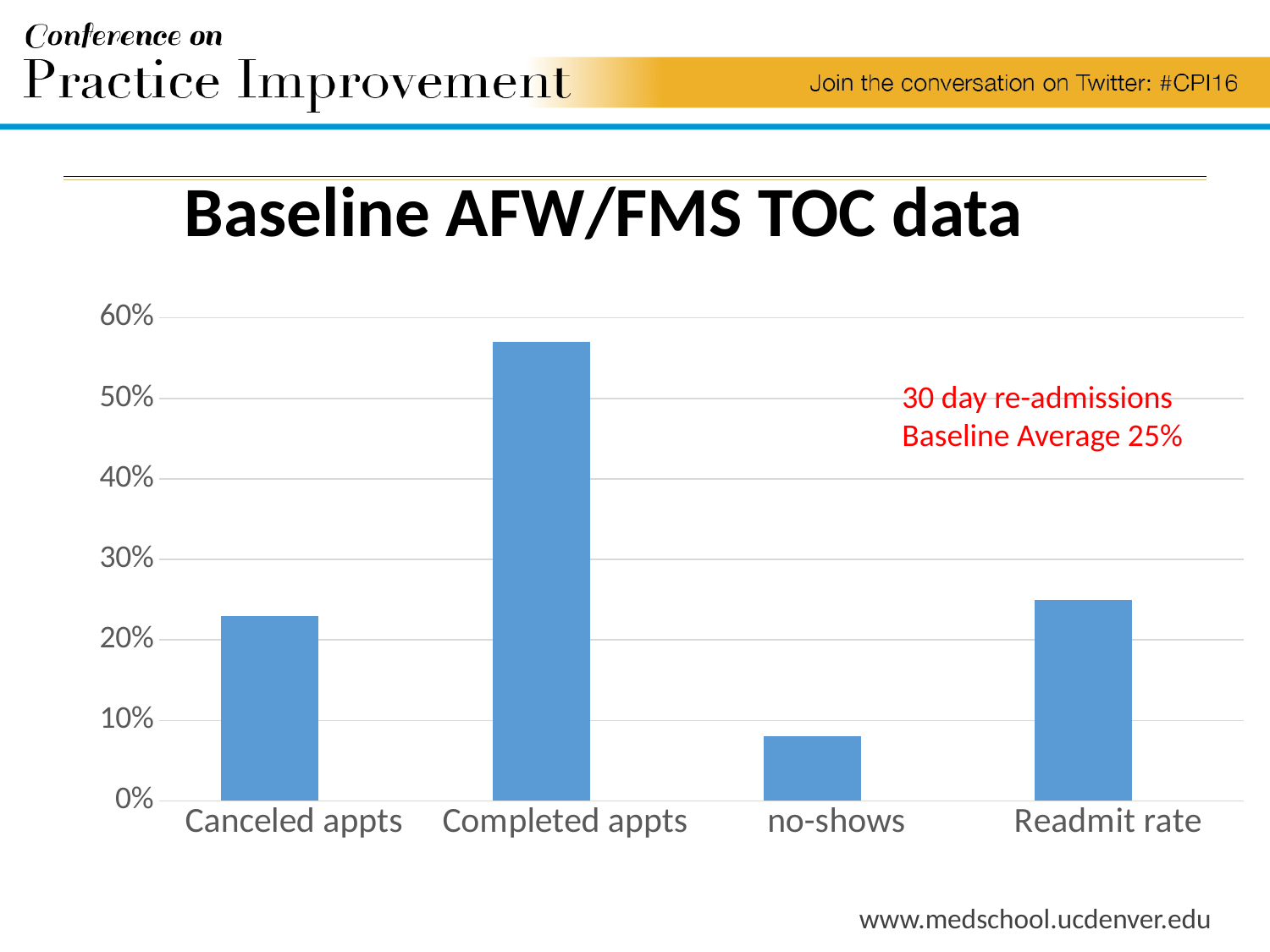
Is the value for no-shows greater or less than 10%? less Which is larger, the value for no-shows or the value for Readmit rate? Readmit rate What type of chart is shown on the slide? Bar chart What is the title of the chart? Baseline AFW/FMS TOC data Is the value for Completed appts greater or less than 50%? greater Which category has the lowest value in the chart? no-shows Is the value for Readmit rate greater or less than 30%? less Which category has the highest value in the chart? Completed appts How many categories are shown on the x axis of the chart? 4 Which is larger, the value for Completed appts or the value for Canceled appts? Completed appts According to the red annotation on the chart, what is the 30 day re-admissions baseline average? 25%